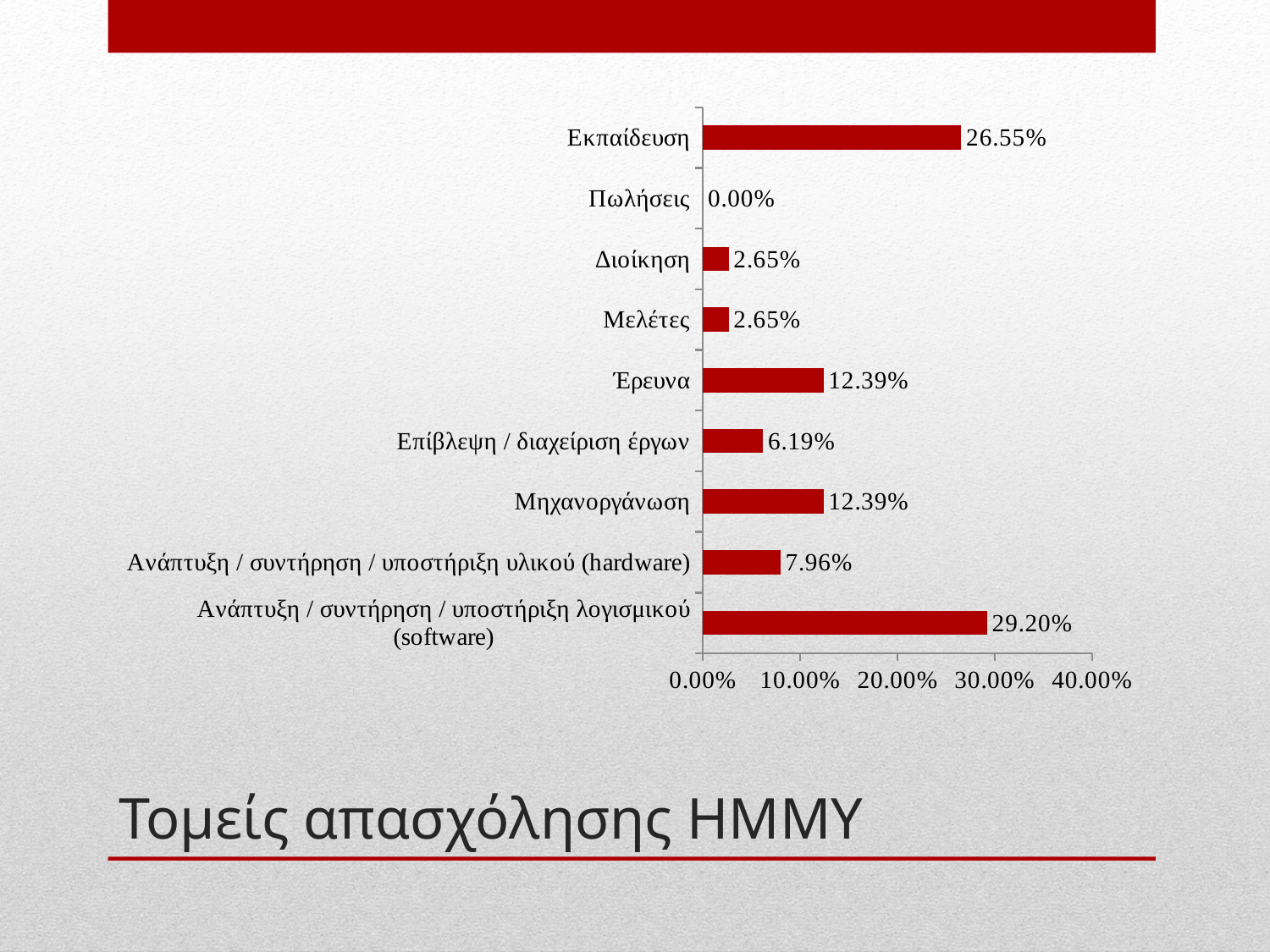
What is the difference between the values for Ανάπτυξη / συντήρηση / υποστήριξη λογισμικού (software) and Εκπαίδευση? 2.65% What is the value for Εκπαίδευση? 26.55% What is the value for Έρευνα? 12.39% What is the value for Ανάπτυξη / συντήρηση / υποστήριξη υλικού (hardware)? 7.96% Which is larger, the value for Έρευνα or the value for Επίβλεψη / διαχείριση έργων? Έρευνα Which category has the highest value? Ανάπτυξη / συντήρηση / υποστήριξη λογισμικού (software) What is the value for Πωλήσεις? 0.00% Which category has the lowest value? Πωλήσεις What is the title of the slide? Τομείς απασχόλησης ΗΜΜΥ What kind of chart is shown on the slide? Bar chart Is the value for Εκπαίδευση greater or less than 20.00%? greater How many categories are shown in the chart? 9